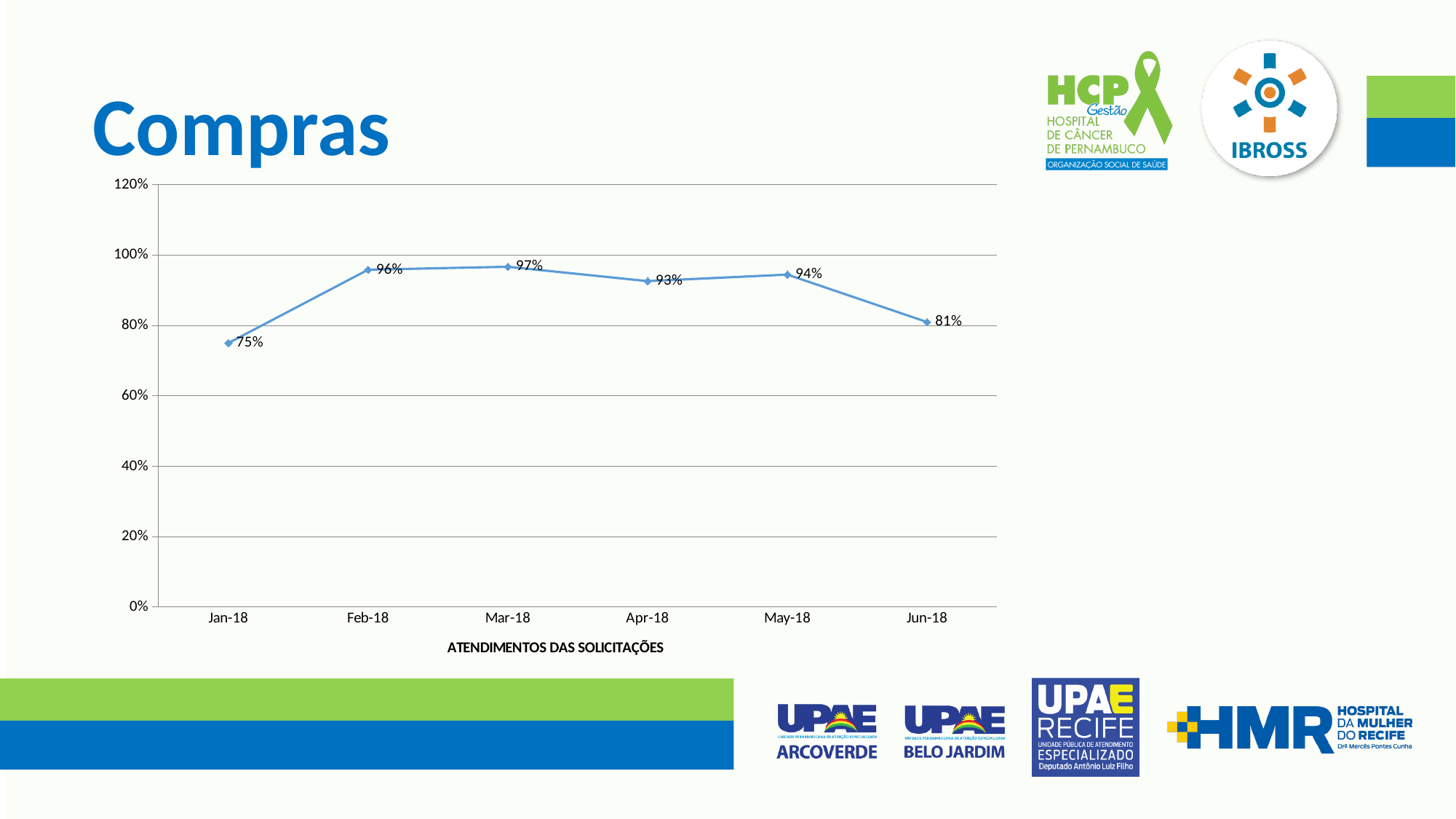
What is the difference between the values for Mar-18 and Jun-18? 16% What is the label shown below the x axis of the chart? ATENDIMENTOS DAS SOLICITAÇÕES Is the value for May-18 greater or less than 80%? greater What is the value for Jun-18? 81% Which is larger, the value for Feb-18 or the value for Apr-18? Feb-18 What is the value for Jan-18? 75% What kind of chart is shown on the slide? line chart What is the value for Mar-18? 97% How many months are plotted on the chart? 6 Does the value rise or fall from May-18 to Jun-18? fall Which month has the highest value? Mar-18 Which month has the lowest value? Jan-18